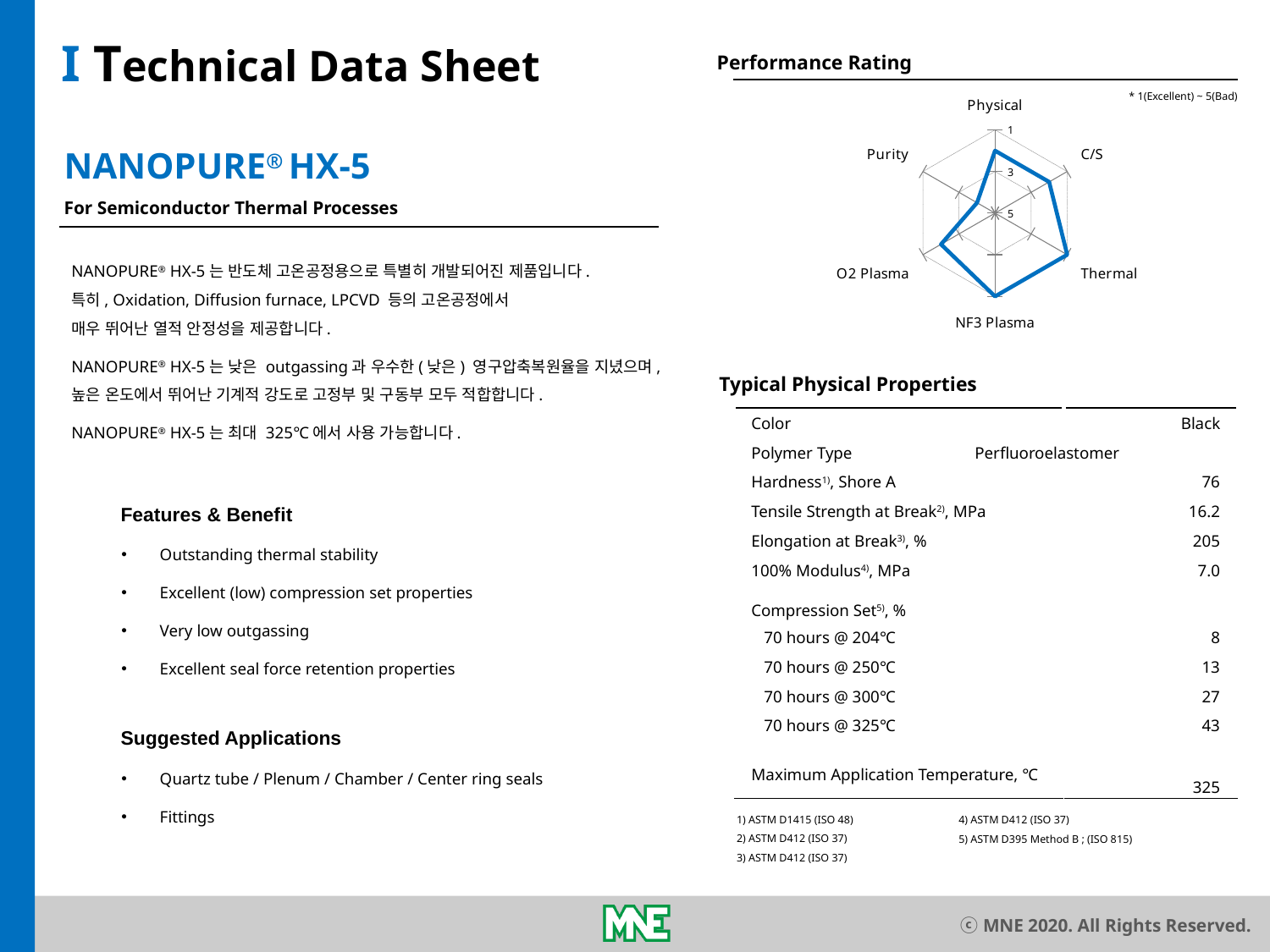
Which category label appears at the top of the Performance Rating radar chart? Physical What rating scale is noted on the Performance Rating chart? 1(Excellent) ~ 5(Bad) On the Performance Rating chart, is the rating value for NF3 Plasma greater or less than 3? less Which category on the Performance Rating chart has the highest (worst) rating value, i.e. the point closest to the centre? Purity On the Performance Rating chart, is the rating value for C/S greater or less than 3? less What kind of chart is shown under "Performance Rating"? Radar chart On the Performance Rating chart, which has the larger rating value (closer to the centre), Purity or NF3 Plasma? Purity How many categories (axes) does the Performance Rating radar chart have? 6 On the Performance Rating chart, which has the larger rating value (closer to the centre), Purity or Thermal? Purity On the Performance Rating chart, is the rating value for Thermal greater or less than 3? less